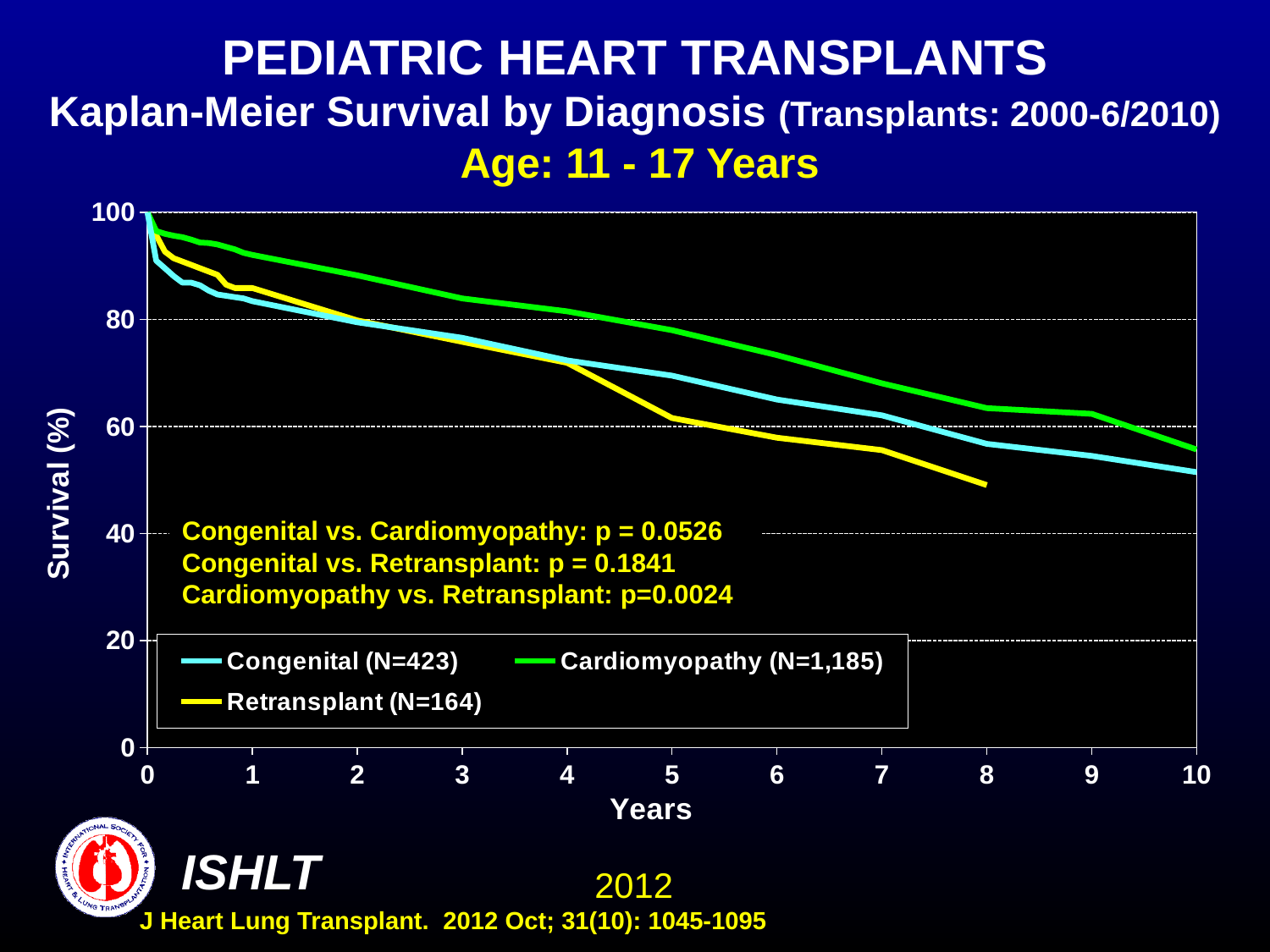
Is the survival value for Congenital at 10 years greater or less than 60? less Which diagnosis group has the lowest survival at 8 years? Retransplant What kind of chart is shown on the slide? Line chart Which diagnosis group has the highest survival at 10 years? Cardiomyopathy Is the survival value for Retransplant at 8 years greater or less than 60? less Is the survival value for Cardiomyopathy at 5 years greater or less than 60? greater What is the N for the Cardiomyopathy group shown in the legend? 1,185 At 6 years, which group has higher survival: Congenital or Retransplant? Congenital Does the survival for the Cardiomyopathy group rise or fall as years increase? Fall At 8 years, which group has higher survival: Cardiomyopathy or Retransplant? Cardiomyopathy How many series does the legend list? 3